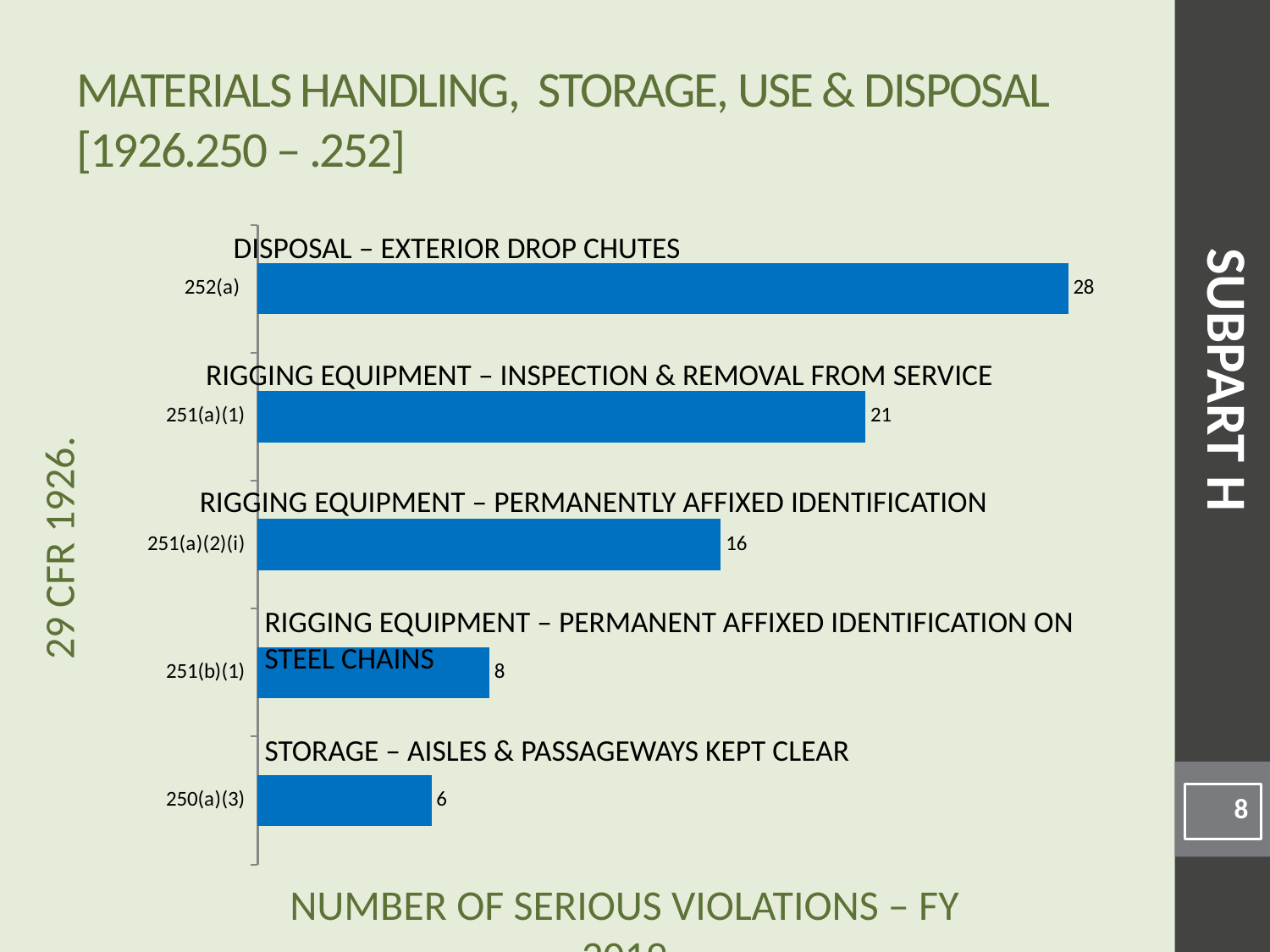
What is the difference between the values for 252(a) and 251(a)(1)? 7 What is the total number of serious violations across all five categories? 79 How many categories are shown in the chart? 5 Which category has the lowest number of serious violations? 250(a)(3) Which has more serious violations, 251(b)(1) or 251(a)(2)(i)? 251(a)(2)(i) Which category has the highest number of serious violations? 252(a) What kind of chart is shown on the slide? Bar chart What colour are the bars in the chart? Blue What is the number of serious violations for 250(a)(3)? 6 What is the number of serious violations for 251(a)(1)? 21 What is the number of serious violations for 252(a)? 28 What is the number of serious violations for 251(a)(2)(i)? 16